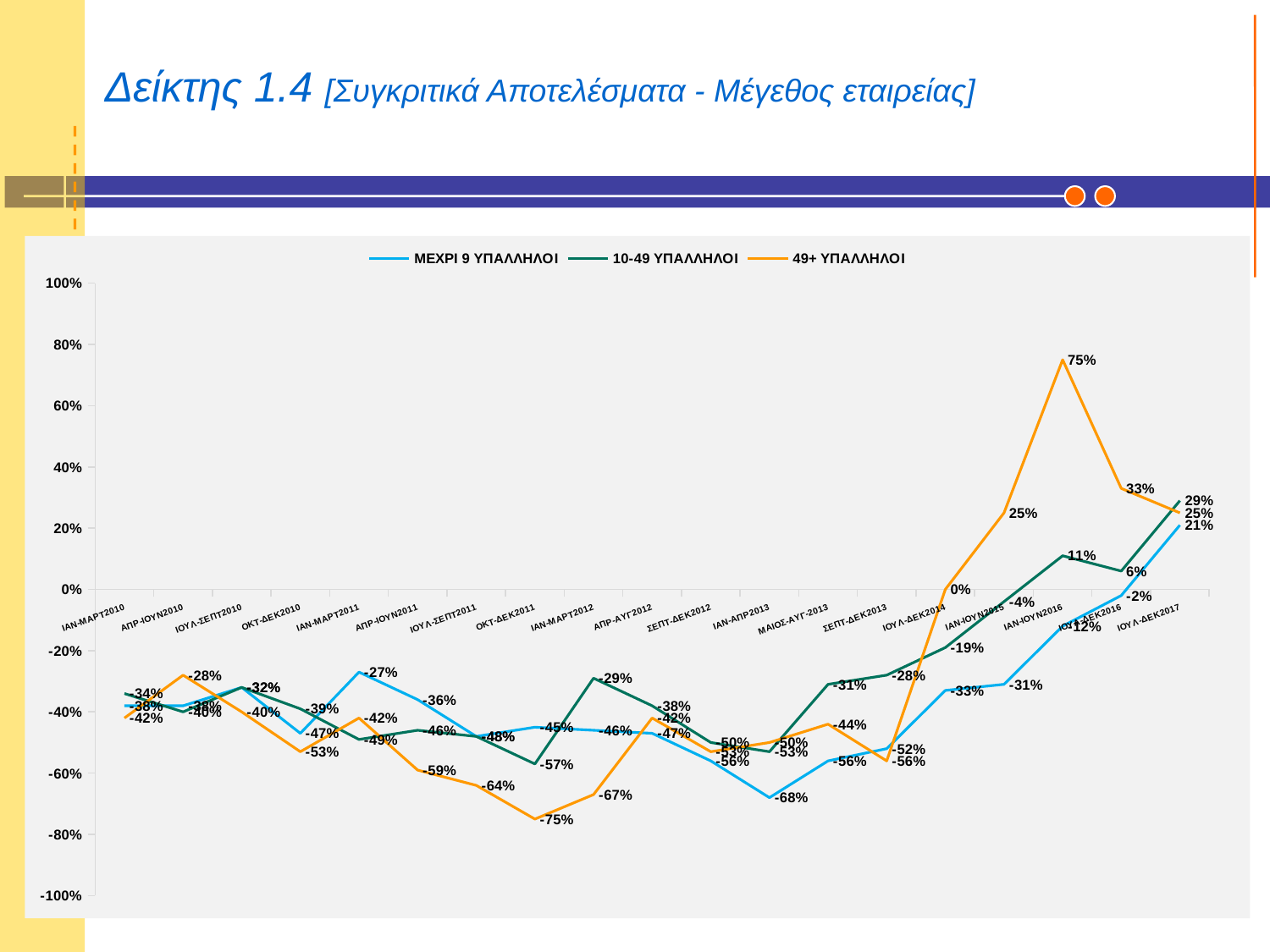
What type of chart is shown on the slide? Line chart What colour is the line for 49+ ΥΠΑΛΛΗΛΟΙ? Orange How many series does the legend list? 3 By how many percentage points did the 49+ ΥΠΑΛΛΗΛΟΙ series fall from ΙΑΝ-ΙΟΥΝ2016 (75%) to ΙΟΥΛ-ΔΕΚ2016 (33%)? 42 percentage points How many time periods are plotted along the x axis? 19 What is the highest value plotted on the chart, and for which series? 75%, 49+ ΥΠΑΛΛΗΛΟΙ What is the value for 49+ ΥΠΑΛΛΗΛΟΙ in ΙΑΝ-ΙΟΥΝ2016? 75% What is the value for 49+ ΥΠΑΛΛΗΛΟΙ in ΟΚΤ-ΔΕΚ2011? -75% What is the lowest value for the ΜΕΧΡΙ 9 ΥΠΑΛΛΗΛΟΙ series, and in which period? -68%, IAN-ΑΠΡ2013